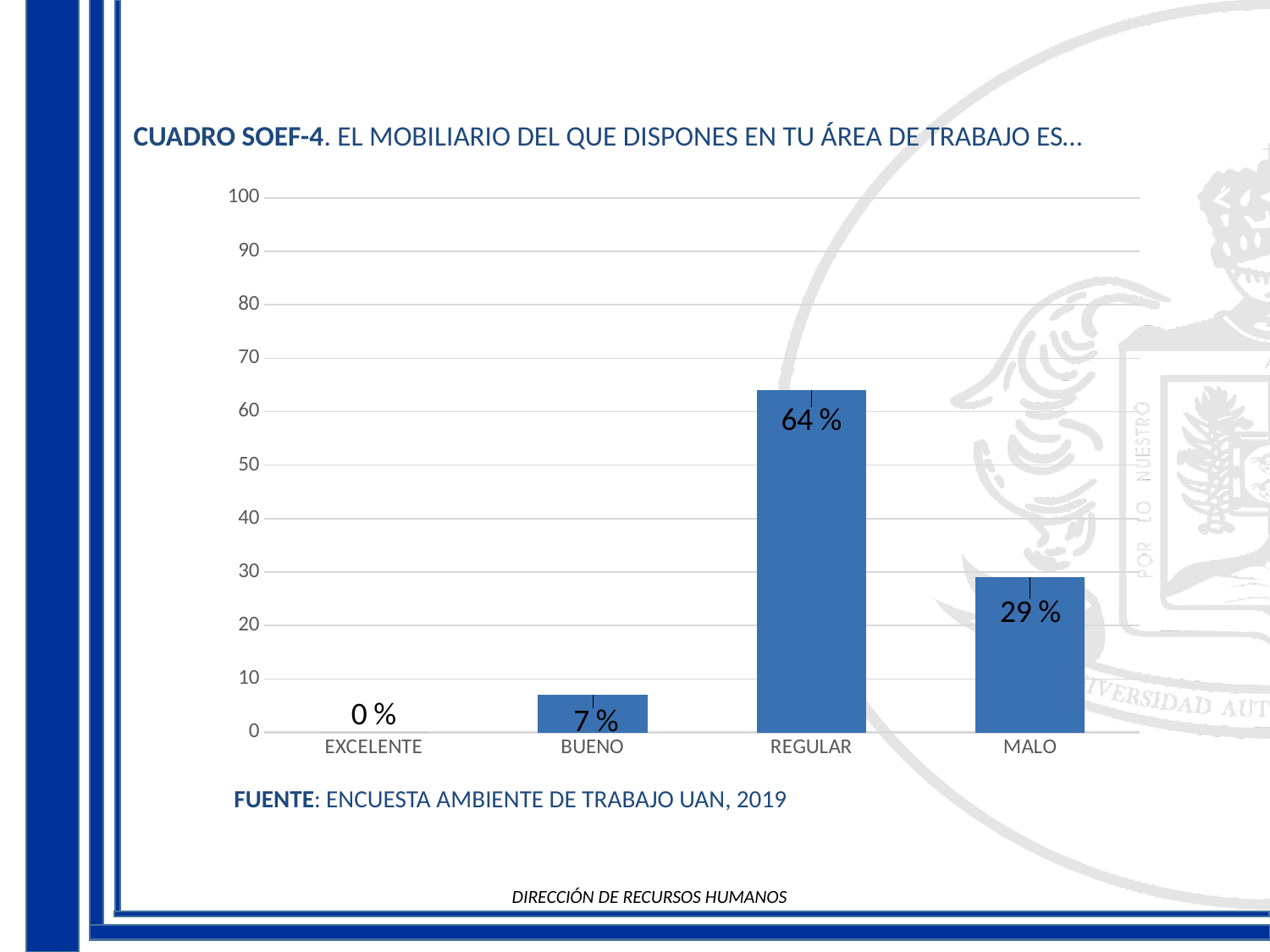
What is the value for MALO? 29 % What kind of chart is shown on the slide? bar chart What is the difference between the values for REGULAR and MALO? 35 % What is the value for REGULAR? 64 % What is the value for BUENO? 7 % What source is cited below the chart? ENCUESTA AMBIENTE DE TRABAJO UAN, 2019 Which category has the highest value? REGULAR Which is larger, the value for BUENO or the value for MALO? MALO What is the value for EXCELENTE? 0 % How many categories are shown on the x axis? 4 Is the value for REGULAR greater or less than 50? greater Which category has the lowest value? EXCELENTE